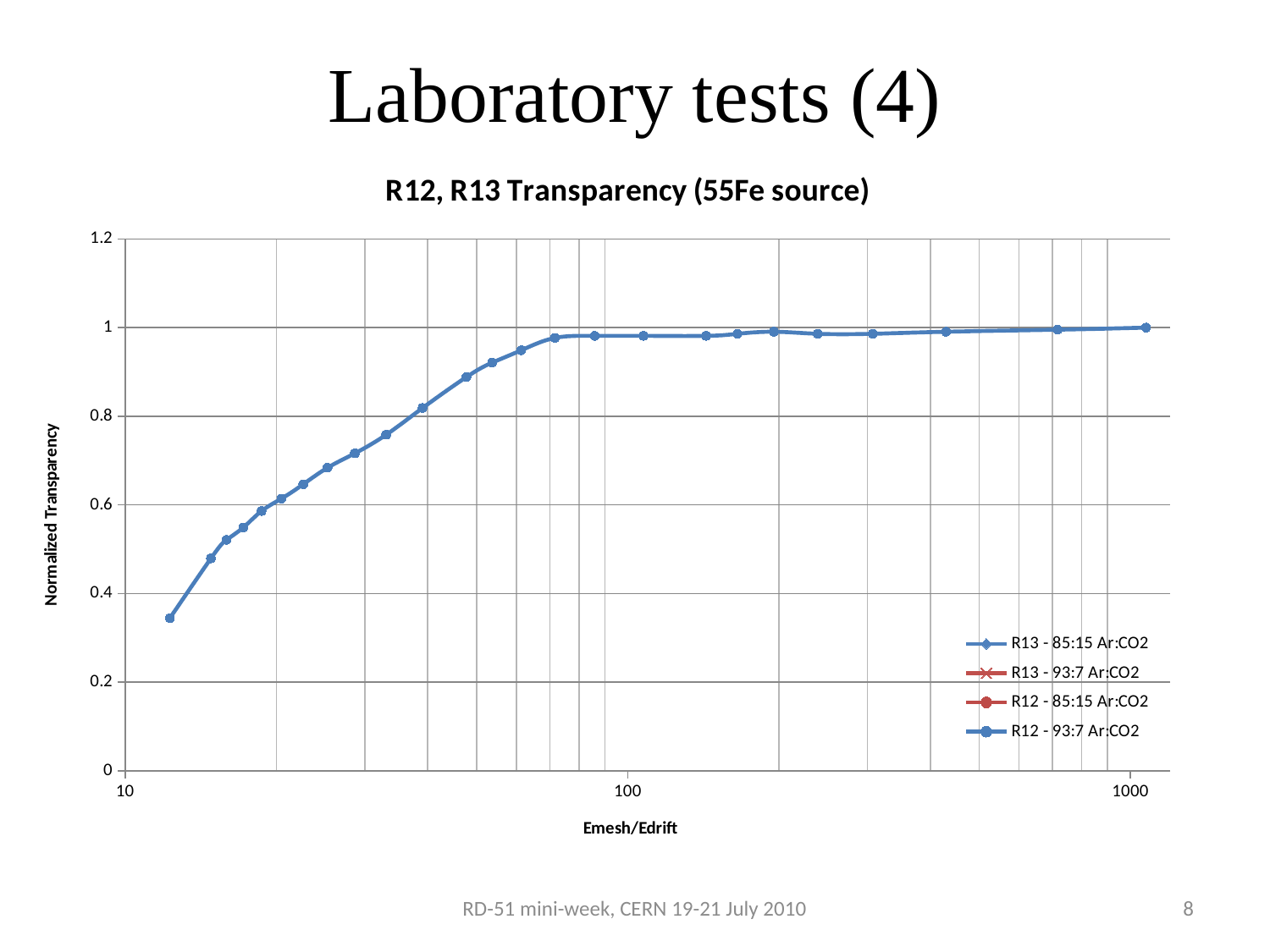
Is the normalized transparency at Emesh/Edrift = 1000 greater or less than 0.8? greater What is the title of the chart? R12, R13 Transparency (55Fe source) Does the normalized transparency rise or fall as Emesh/Edrift increases from 10 to 100? rises What is the highest value shown on the y axis? 1.2 Is the normalized transparency at Emesh/Edrift = 20 greater or less than 0.8? less What kind of chart is shown on the slide? line chart How many series does the chart legend list? 4 Is the normalized transparency at the leftmost plotted point greater or less than 0.4? less Which is larger, the normalized transparency at Emesh/Edrift = 20 or at Emesh/Edrift = 100? at Emesh/Edrift = 100 What is the label of the y axis? Normalized Transparency